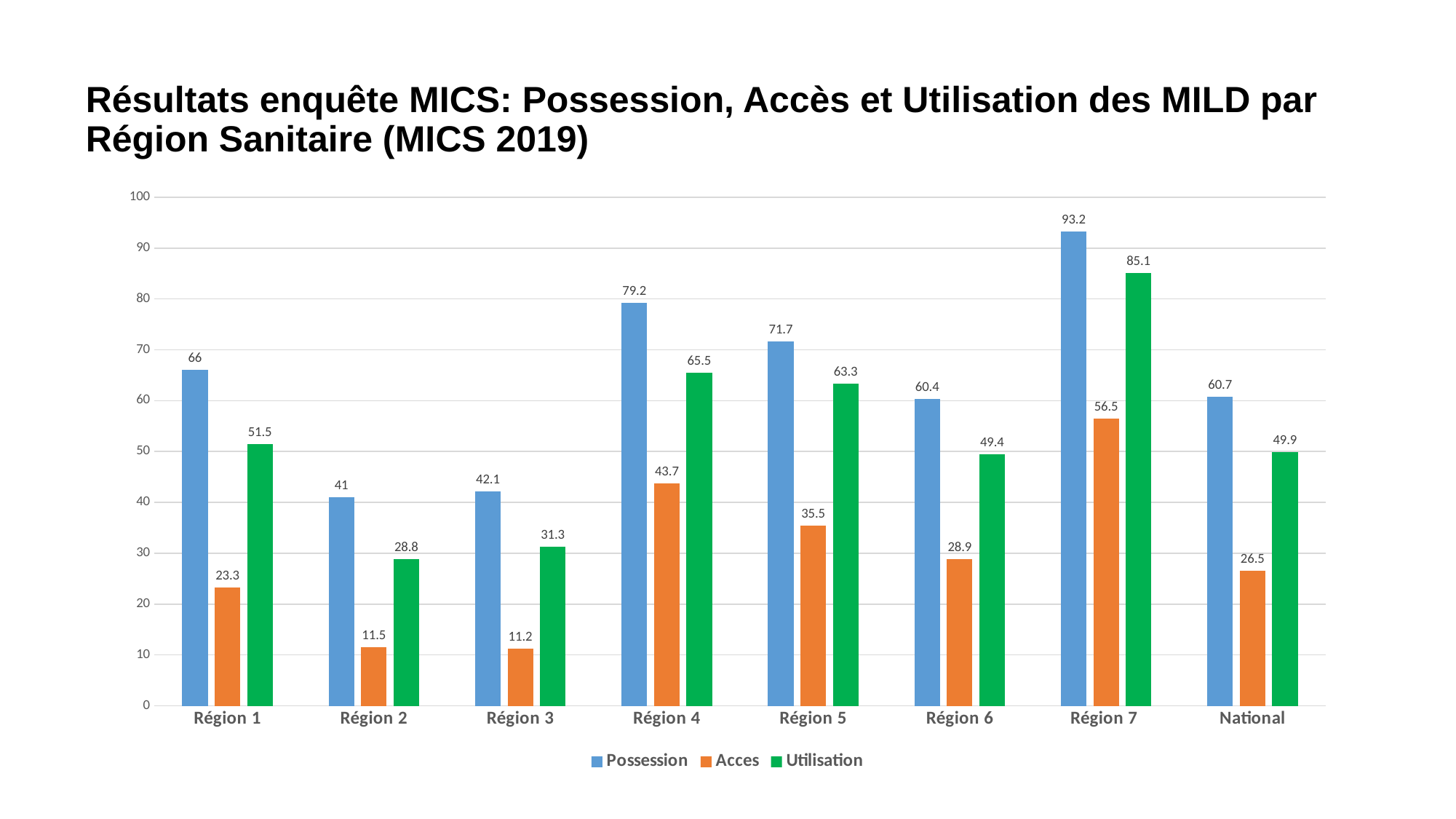
Is the Acces value for Région 5 greater or less than 40? less Which category has the highest Possession value? Région 7 What is the Possession value for Région 4? 79.2 What is the difference between the Possession and Utilisation values for Région 7? 8.1 Which colour represents the Acces series in the legend? orange Which category has the lowest Acces value? Région 3 What kind of chart is shown on the slide? bar chart What is the Acces value for Région 2? 11.5 What is the Utilisation value for National? 49.9 Which is larger, the Utilisation value for Région 1 or the Utilisation value for Région 6? Région 1 How many series does the legend list? 3 How many categories are shown on the x axis? 8